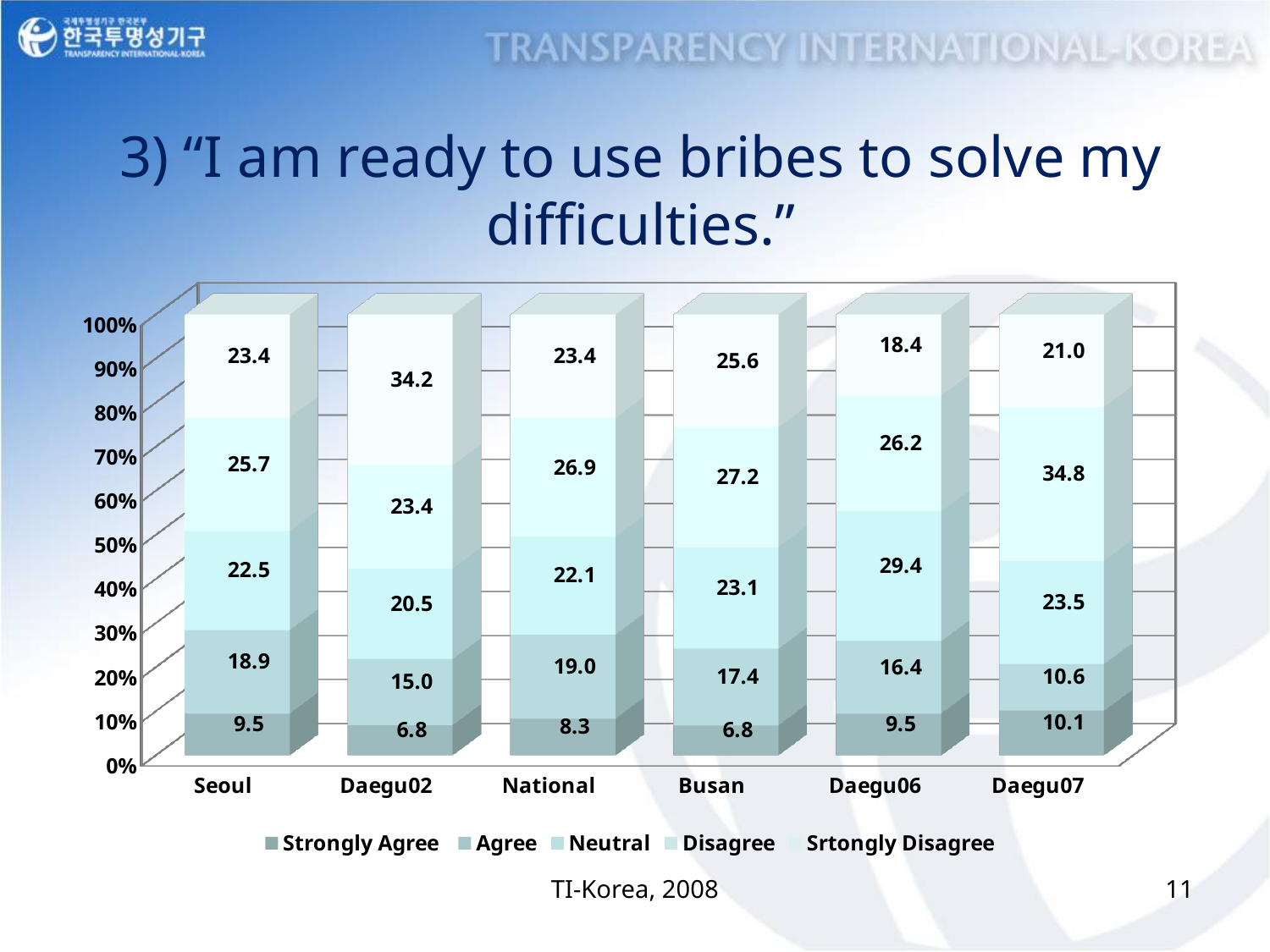
What is the label of the last legend entry? Srtongly Disagree What is the Srtongly Disagree value for Daegu02? 34.2 What is the Disagree value for Daegu07? 34.8 Which is larger, the Neutral value for Busan or the Neutral value for Daegu06? Daegu06 How many series does the legend list? 5 What kind of chart is shown on the slide? Stacked bar chart Which category has the lowest Agree value? Daegu07 What is the difference between the Srtongly Disagree values for Daegu02 and Daegu06? 15.8 How many categories are shown on the x axis? 6 Which category has the highest Strongly Agree value? Daegu07 What is the Neutral value for Daegu06? 29.4 What is the Strongly Agree value for Seoul? 9.5